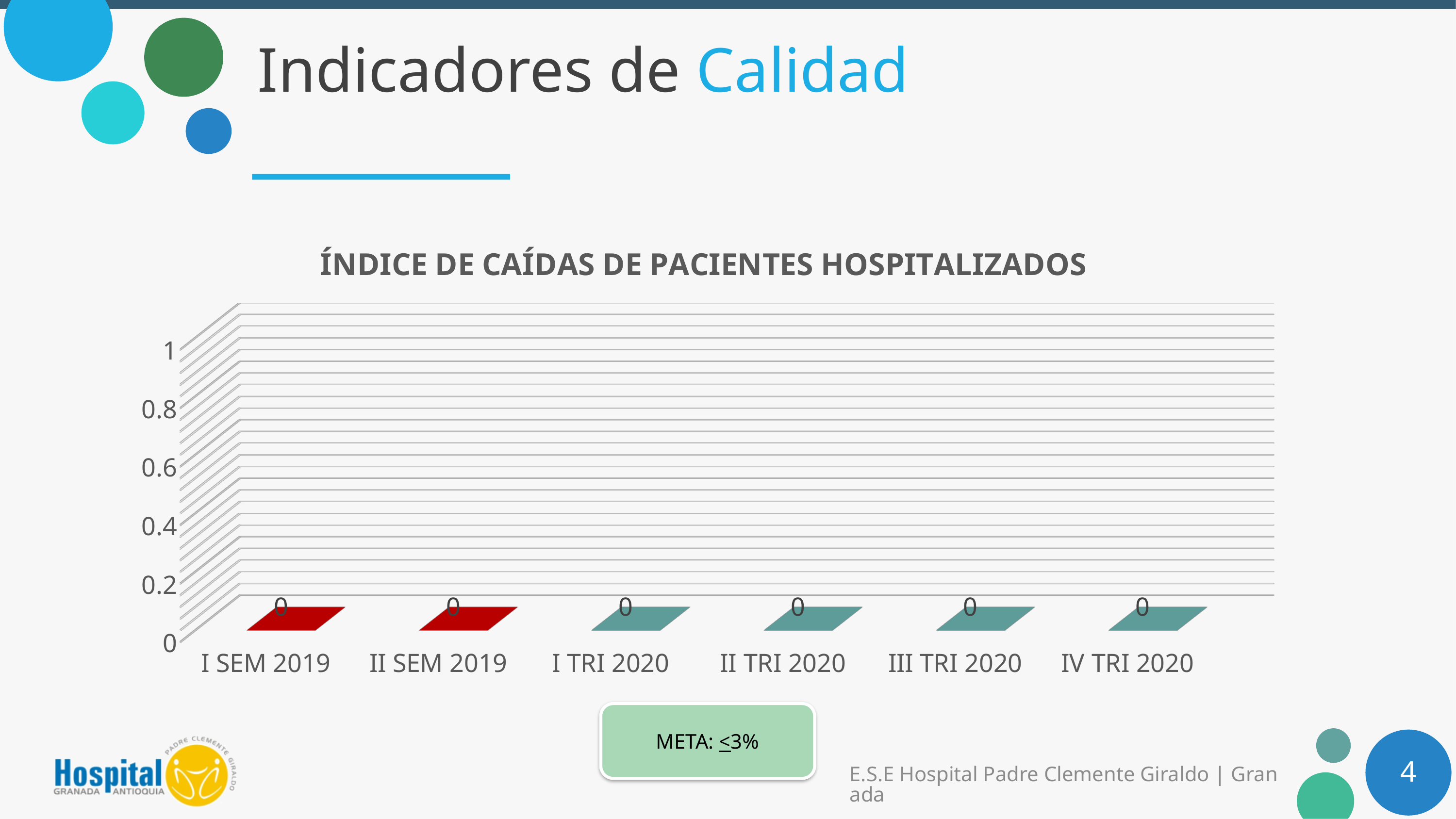
What is the value for IV TRI 2020? 0 What is the difference between the values for I SEM 2019 and III TRI 2020? 0 What is the value for II SEM 2019? 0 What is the total of the values for I SEM 2019 and II SEM 2019? 0 How many categories are shown on the x axis of the chart? 6 What is the title of the chart? ÍNDICE DE CAÍDAS DE PACIENTES HOSPITALIZADOS Do the values rise, fall, or stay the same from I SEM 2019 to IV TRI 2020? stay the same What is the value for I SEM 2019? 0 What kind of chart is shown on the slide? bar chart What is the value for I TRI 2020? 0 Is the value for II TRI 2020 greater or less than 0.2? less What is the highest value shown on the y axis of the chart? 1